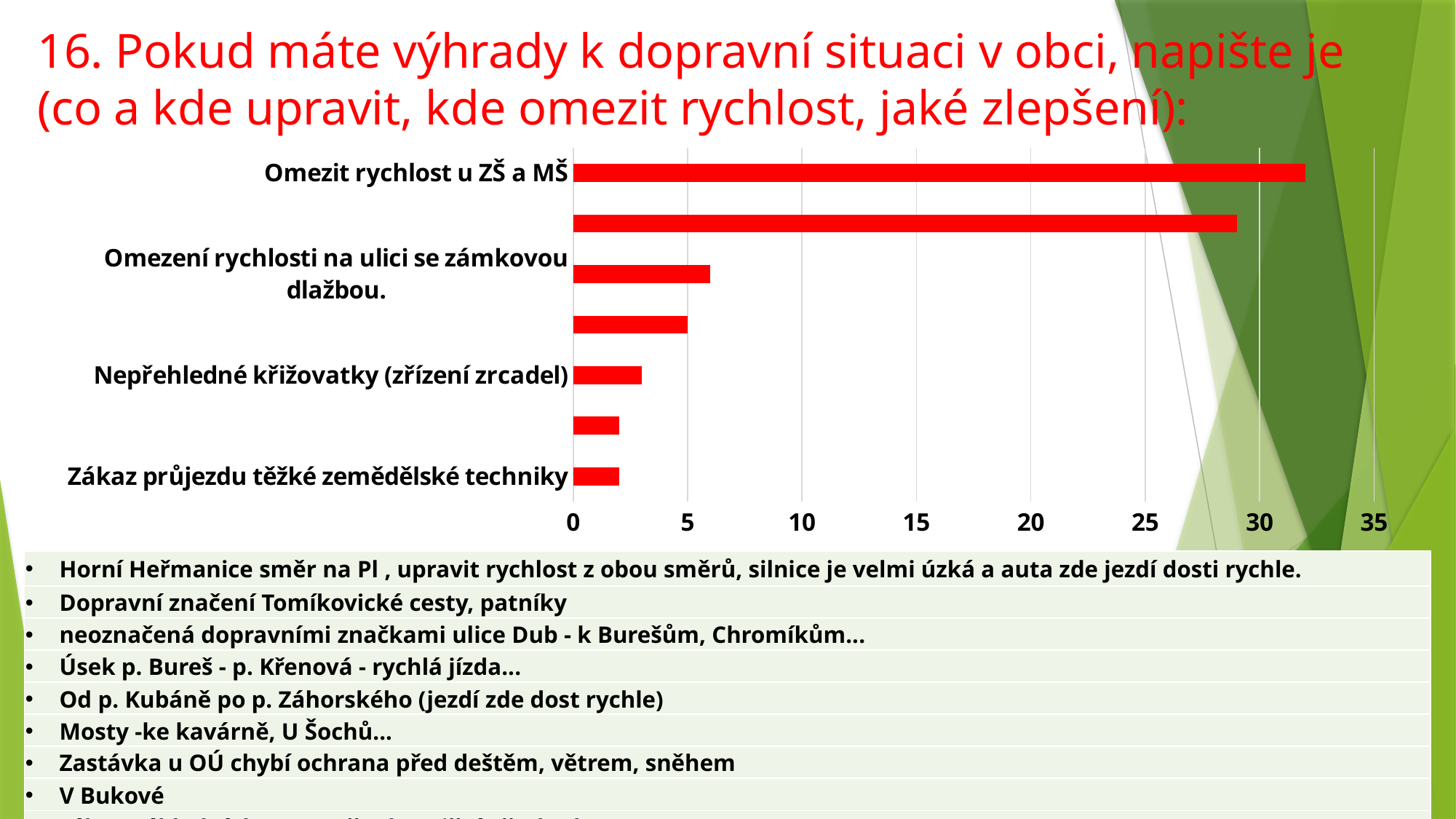
Which is larger: the value for "Nepřehledné křižovatky (zřízení zrcadel)" or the value for "Zákaz průjezdu těžké zemědělské techniky"? Nepřehledné křižovatky (zřízení zrcadel) Is the value for "Nepřehledné křižovatky (zřízení zrcadel)" greater or less than 5? less Is the value for "Zákaz průjezdu těžké zemědělské techniky" greater or less than 5? less Is the value for "Omezení rychlosti na ulici se zámkovou dlažbou." greater or less than 10? less How many bars are plotted in the chart? 7 Which is larger: the value for "Omezit rychlost u ZŠ a MŠ" or the value for "Omezení rychlosti na ulici se zámkovou dlažbou."? Omezit rychlost u ZŠ a MŠ Which category has the longest bar in the chart? Omezit rychlost u ZŠ a MŠ What kind of chart is shown on the slide? bar chart What colour are the bars in the chart? red What is the highest value shown on the horizontal axis of the chart? 35